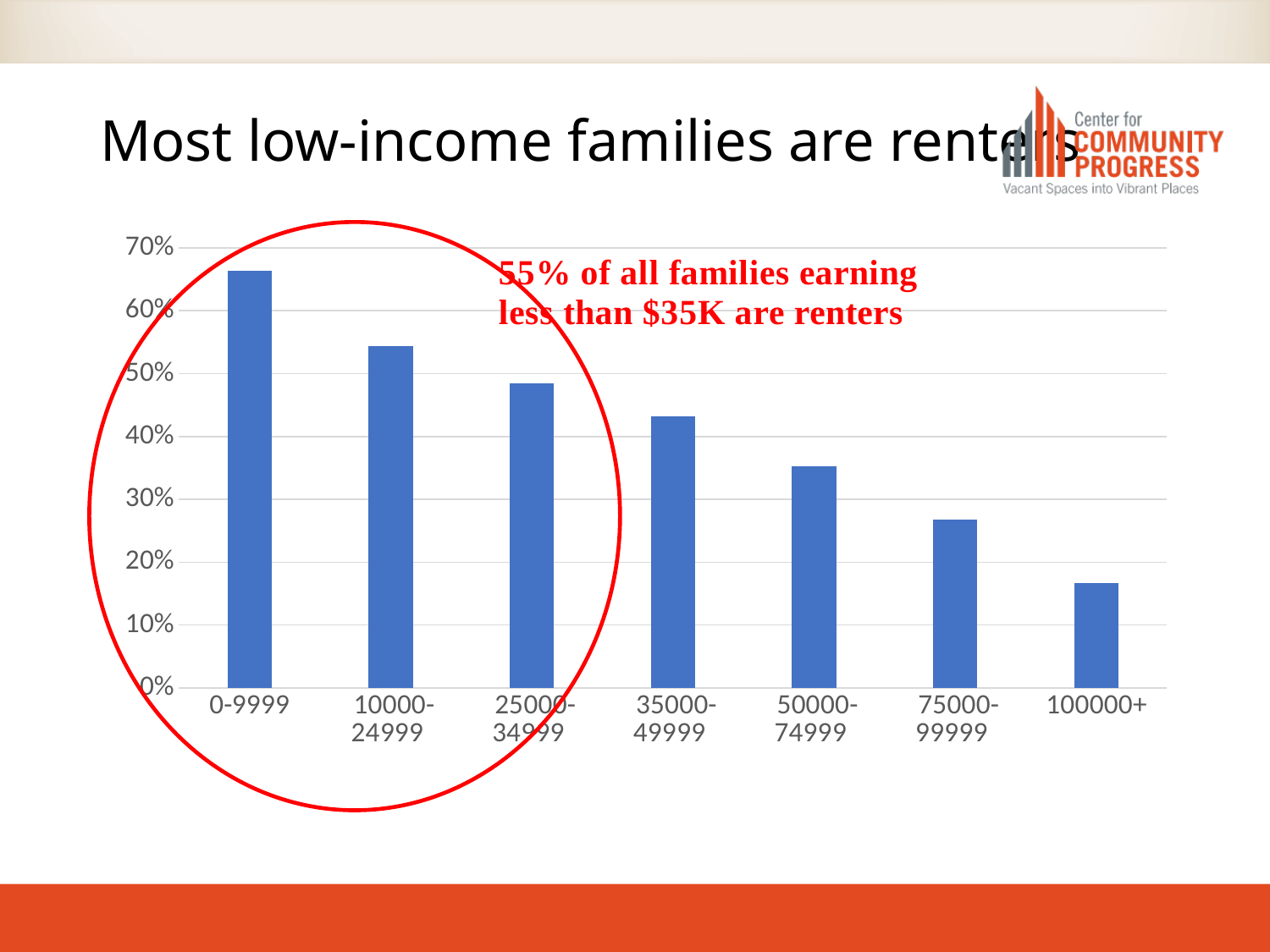
Which income category has the highest bar in the chart? 0-9999 What kind of chart is shown on the slide? bar chart Is the value for 35000-49999 greater or less than 50%? less Is the value for 10000-24999 greater or less than 50%? greater What is the title of the slide containing the chart? Most low-income families are renters How many income categories are shown on the x axis of the chart? 7 Is the value for 100000+ greater or less than 20%? less Which income category has the lowest bar in the chart? 100000+ Do the bar values rise or fall as income increases along the x axis? fall Which is larger, the value for 25000-34999 or the value for 75000-99999? 25000-34999